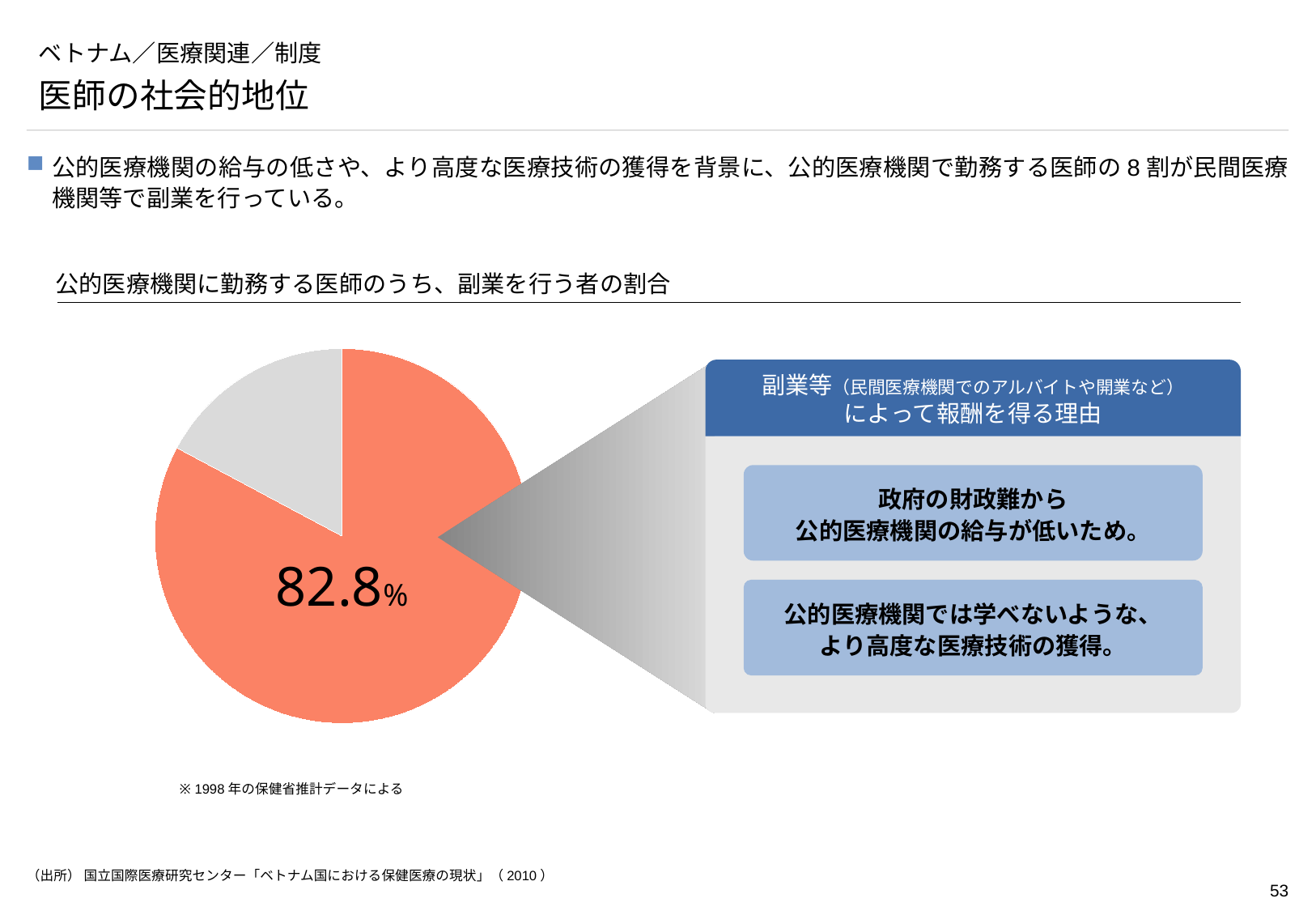
What share of the pie does the orange slice represent? 82.8% What percentage of doctors working at public medical institutions engage in side jobs, according to the pie chart? 82.8% How many slices does the pie chart have? 2 Which slice of the pie chart is the smallest? the gray slice What kind of chart is shown on the slide? pie chart What is the title of the pie chart? 公的医療機関に勤務する医師のうち、副業を行う者の割合 Which slice of the pie chart is larger, the orange one or the gray one? the orange one What colour is the slice labelled 82.8%? orange